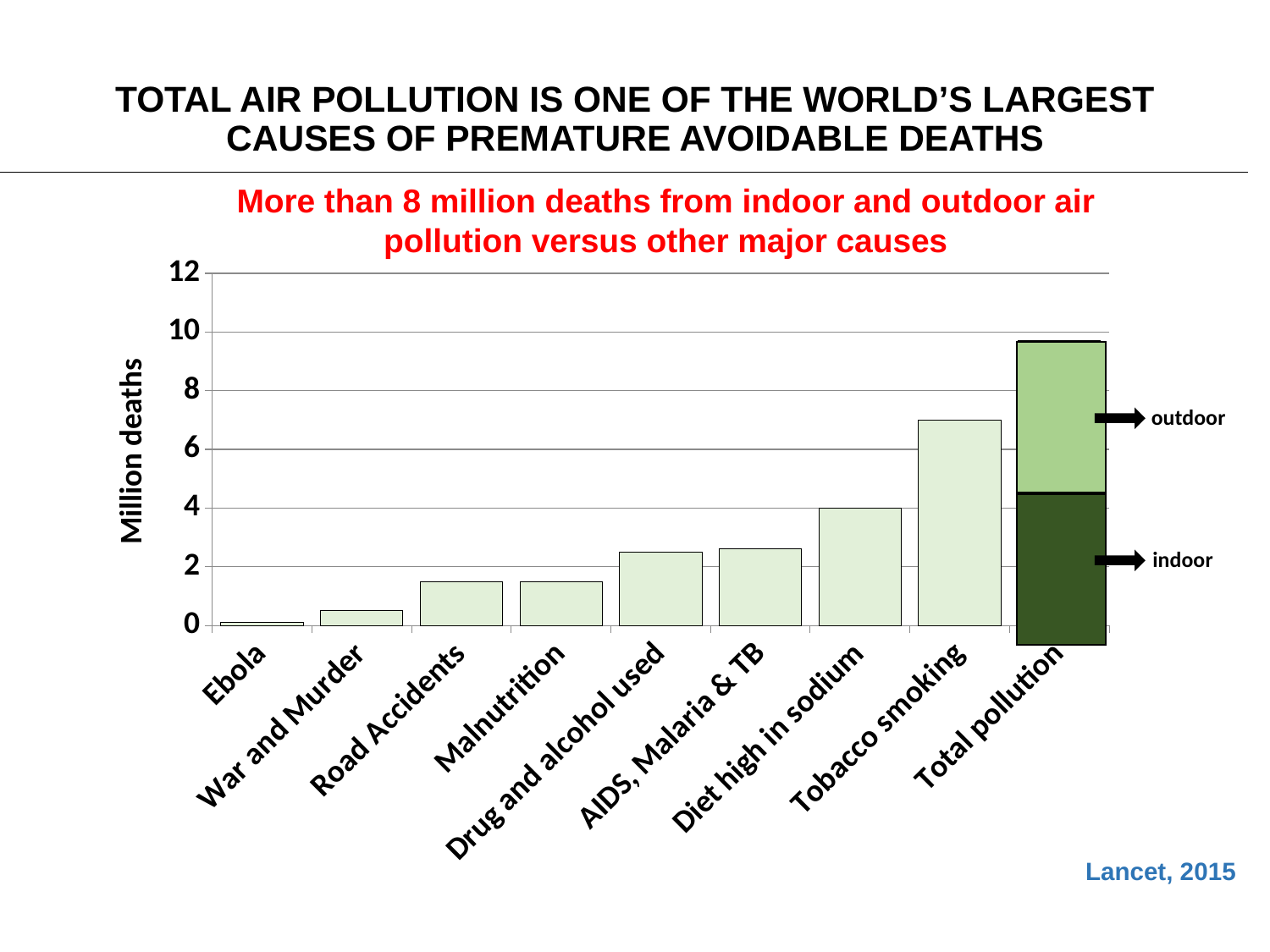
Which category has the lowest number of deaths in the chart? Ebola Do the values rise or fall moving from left to right along the x axis? rise Is the value for Drug and alcohol used greater or less than 2 million deaths? greater What is the label on the y axis of the chart? Million deaths Is the value for Tobacco smoking greater or less than 6 million deaths? greater Is the value for War and Murder greater or less than 2 million deaths? less Which is larger, the value for Tobacco smoking or the value for Diet high in sodium? Tobacco smoking What are the two segments of the Total pollution bar labelled? outdoor and indoor Which category has the highest number of deaths in the chart? Total pollution How many categories are shown on the x axis of the chart? 9 What kind of chart is shown on the slide? bar chart